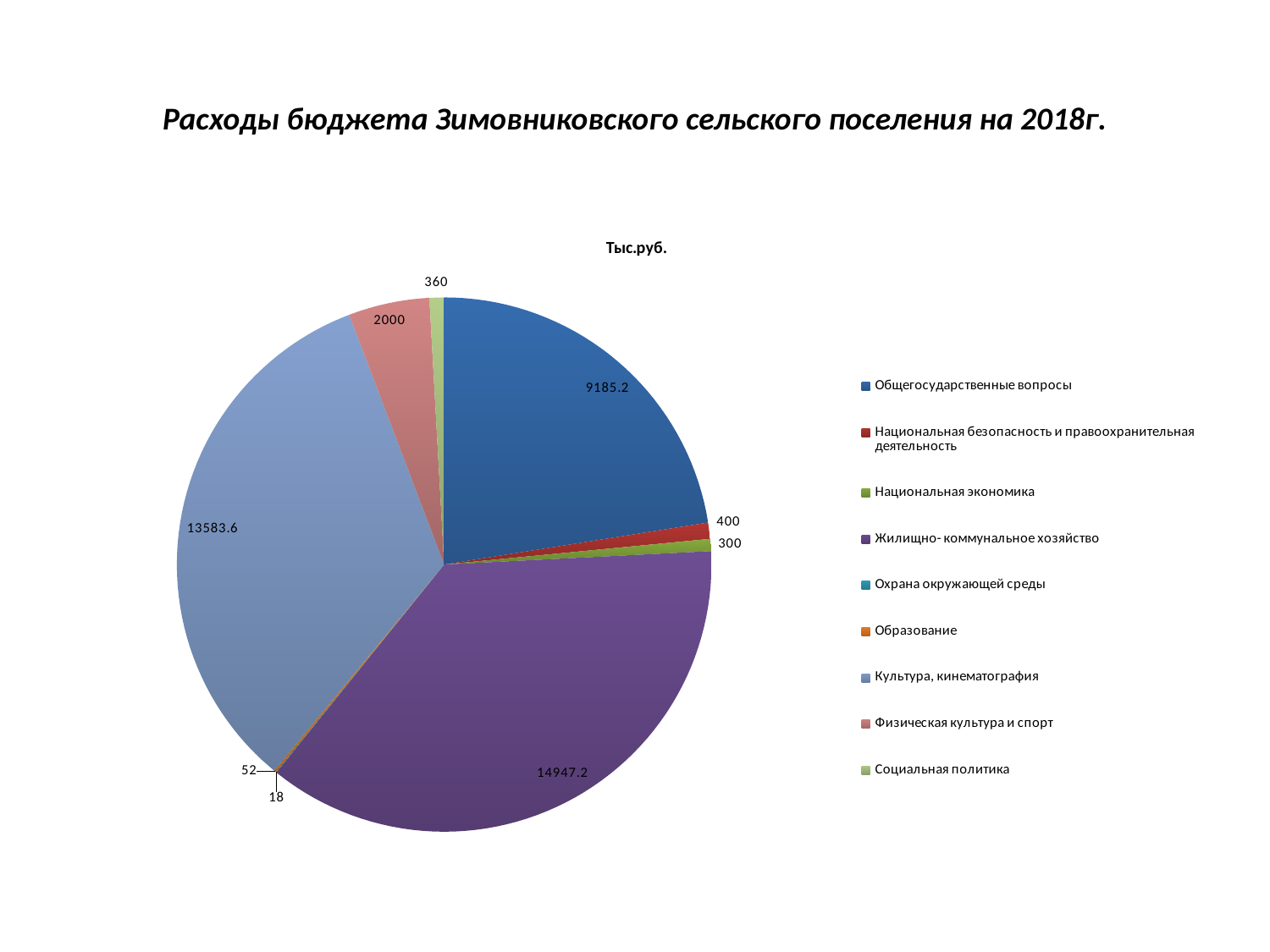
What is the value for Культура, кинематография? 13583.6 What is the value for Физическая культура и спорт? 2000 What kind of chart is shown on the slide? Pie chart Which category has the smallest slice of the pie? Охрана окружающей среды What is the value for Общегосударственные вопросы? 9185.2 Which is larger: the value for Национальная безопасность и правоохранительная деятельность or the value for Национальная экономика? Национальная безопасность и правоохранительная деятельность What is the difference between the values for Жилищно- коммунальное хозяйство and Культура, кинематография? 1363.6 Which category has the largest slice of the pie? Жилищно- коммунальное хозяйство How many categories does the legend list? 9 What is the value for Социальная политика? 360 What is the title shown above the pie chart? Тыс.руб. What is the value for Жилищно- коммунальное хозяйство? 14947.2